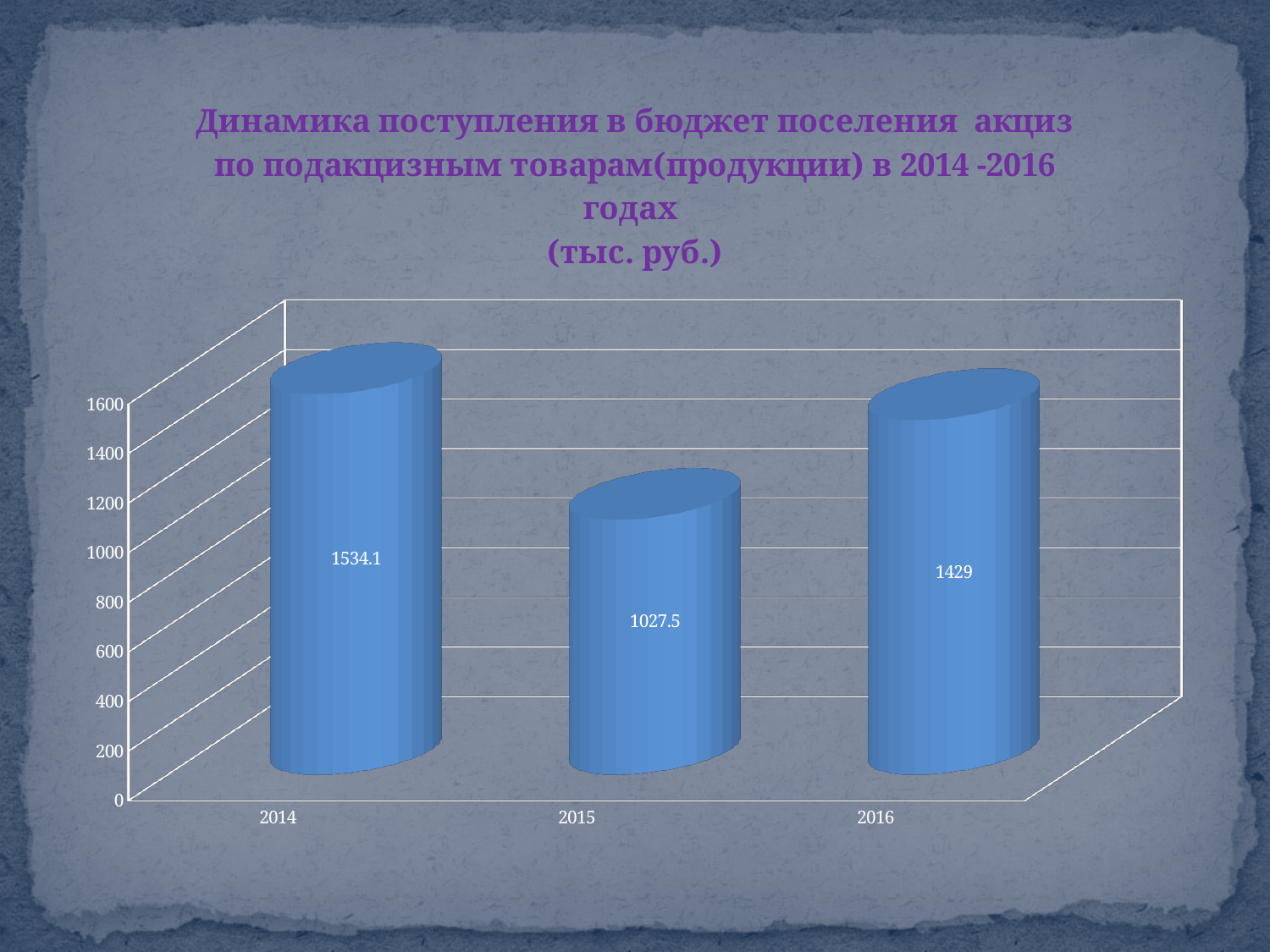
Is the value for 2015 greater or less than 1200? less What is the difference between the values for 2016 and 2015? 401.5 What is the value for 2015? 1027.5 How many years are shown on the x axis? 3 What is the difference between the values for 2014 and 2015? 506.6 What unit is given in the chart title? тыс. руб. Which year has the highest value? 2014 What is the value for 2014? 1534.1 What kind of chart is this? bar chart Which is larger, the value for 2014 or the value for 2016? 2014 What is the value for 2016? 1429 Which year has the lowest value? 2015